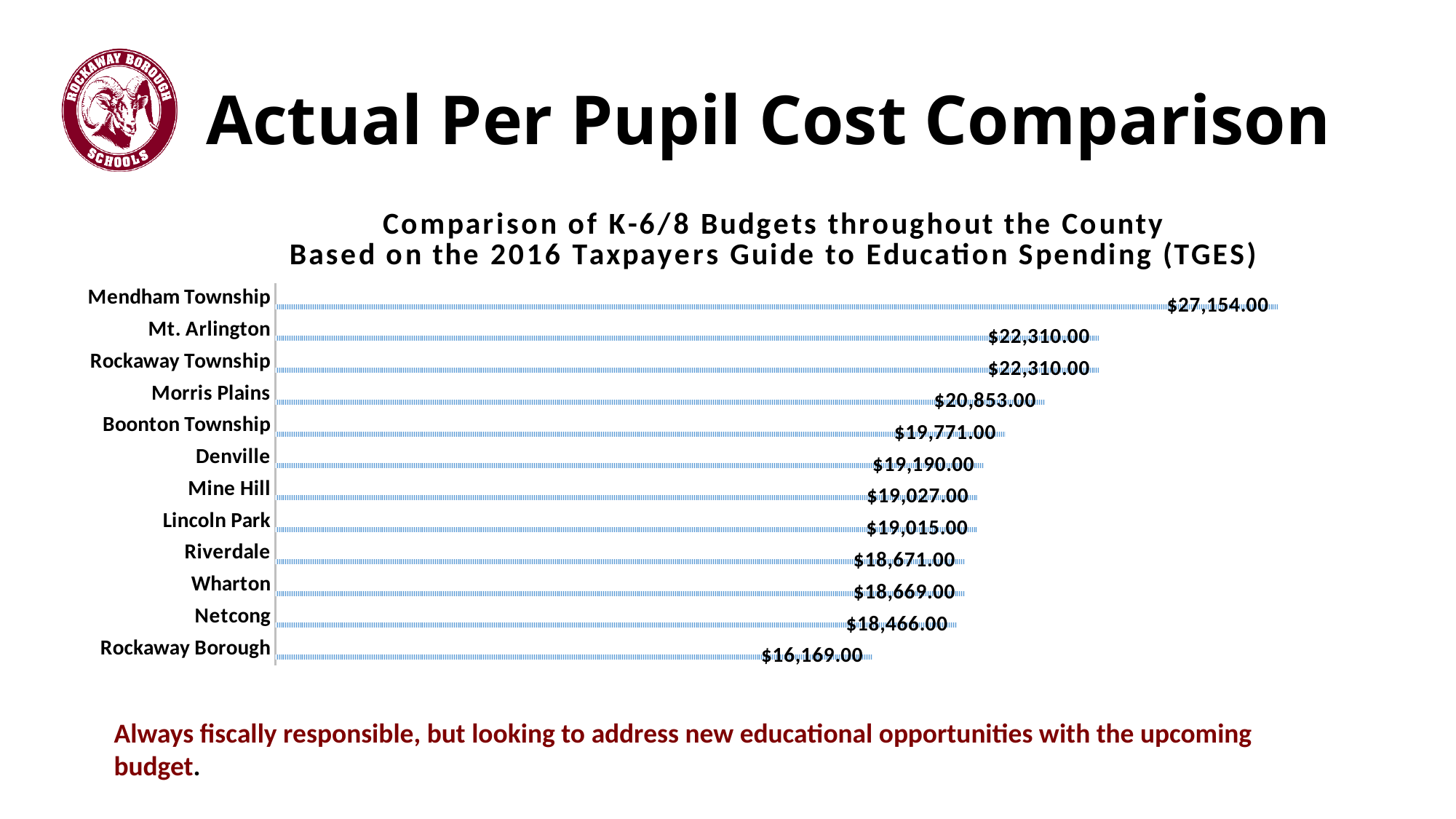
Which district has the lowest per pupil cost in the chart? Rockaway Borough What is the difference between the per pupil cost of Mendham Township and Rockaway Borough? $10,985.00 What is the per pupil cost shown for Netcong? $18,466.00 What kind of chart is shown on the slide? Bar chart What is the per pupil cost shown for Morris Plains? $20,853.00 How many districts are shown in the chart? 12 What is the difference between the per pupil cost of Morris Plains and Denville? $1,663.00 Which has a higher per pupil cost, Boonton Township or Netcong? Boonton Township What is the per pupil cost shown for Rockaway Borough? $16,169.00 Which district has the highest per pupil cost in the chart? Mendham Township What is the title of the chart? Comparison of K-6/8 Budgets throughout the County Based on the 2016 Taxpayers Guide to Education Spending (TGES) What is the per pupil cost shown for Mendham Township? $27,154.00